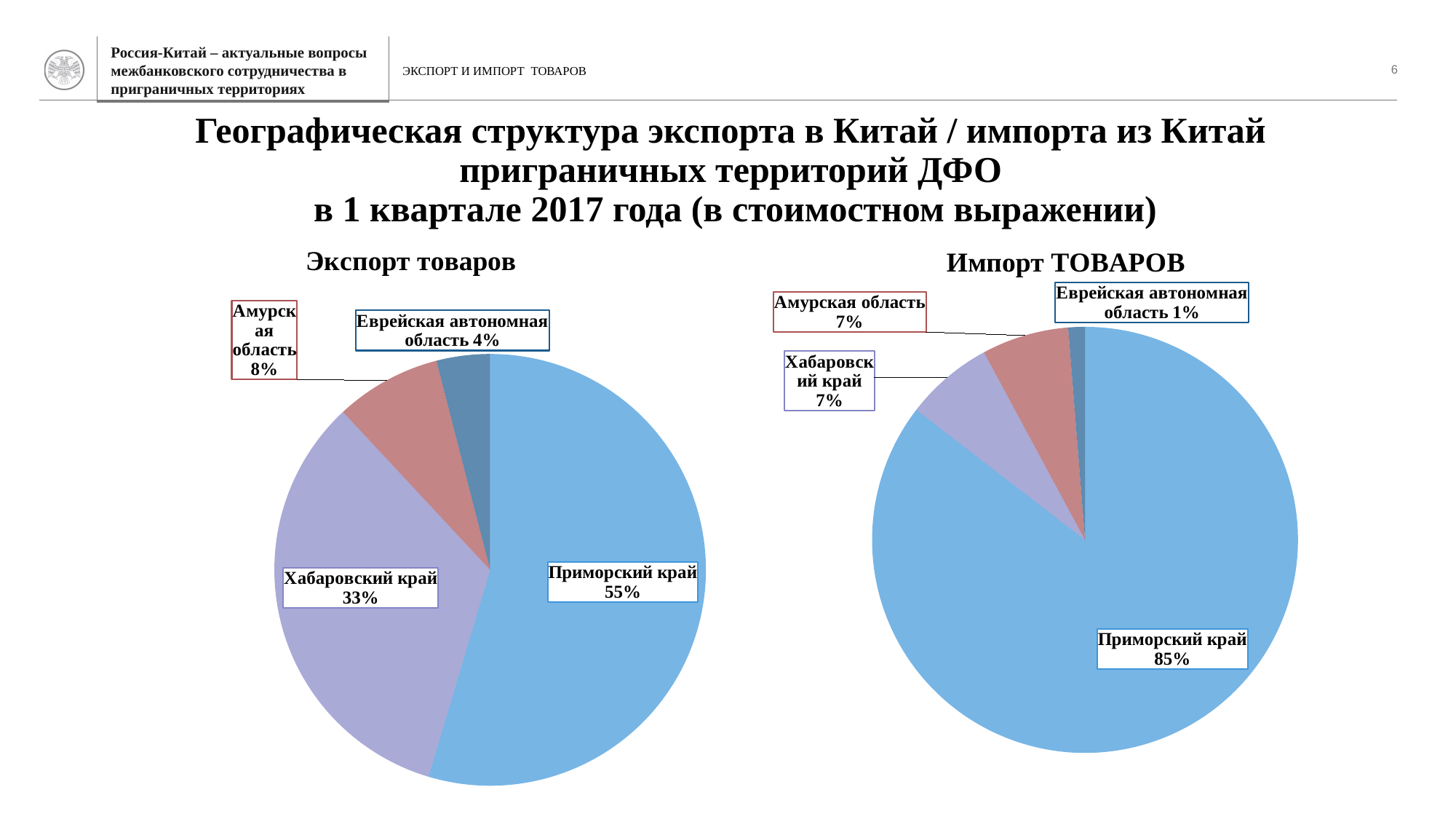
In the 'Импорт ТОВАРОВ' chart, what share does Еврейская автономная область have? 1% How many slices does the 'Импорт ТОВАРОВ' chart have? 4 In the 'Экспорт товаров' chart, which region has the smallest share? Еврейская автономная область What type of chart is the 'Экспорт товаров' chart? Pie chart In the 'Экспорт товаров' chart, what share does Приморский край have? 55% In the 'Импорт ТОВАРОВ' chart, which region has the smallest share? Еврейская автономная область Which is larger: the share of Хабаровский край in the 'Экспорт товаров' chart or in the 'Импорт ТОВАРОВ' chart? Экспорт товаров In the 'Экспорт товаров' chart, what share does Амурская область have? 8% In the 'Импорт ТОВАРОВ' chart, what share does Приморский край have? 85% In the 'Экспорт товаров' chart, what share does Хабаровский край have? 33% In the 'Экспорт товаров' chart, which region has the largest share? Приморский край In the 'Экспорт товаров' chart, what is the difference in percentage points between Приморский край and Хабаровский край? 22